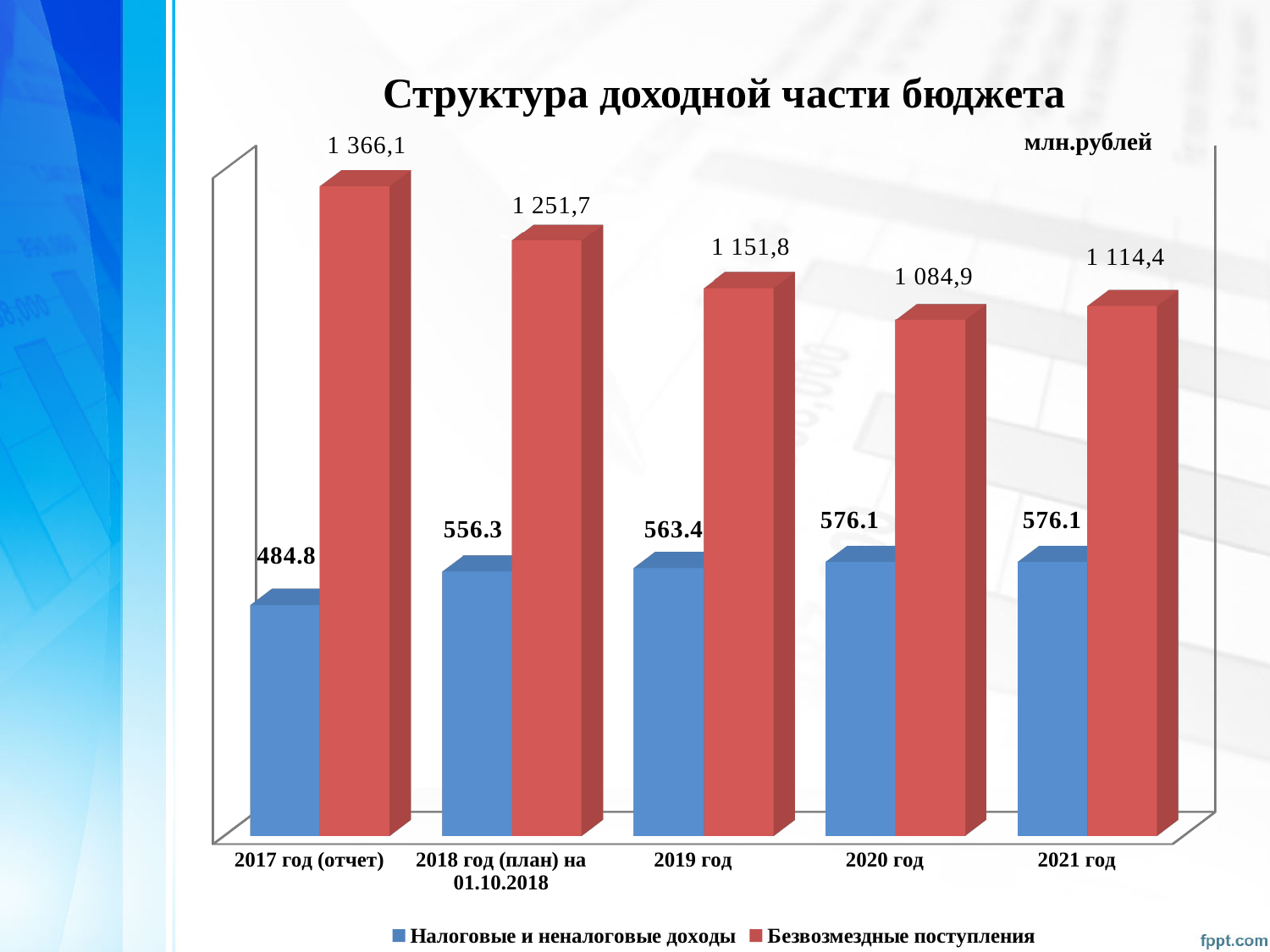
What is the value of Безвозмездные поступления for 2019 год? 1 151,8 What is the difference in Налоговые и неналоговые доходы between 2019 год and 2018 год (план) на 01.10.2018? 7.1 In which year is Безвозмездные поступления the highest? 2017 год (отчет) By how much does Безвозмездные поступления in 2017 год (отчет) exceed that in 2018 год (план) на 01.10.2018? 114,4 Which year has the larger value of Безвозмездные поступления, 2020 год or 2021 год? 2021 год In which year is Безвозмездные поступления the lowest? 2020 год How many series does the legend list? 2 What is the value of Налоговые и неналоговые доходы for 2017 год (отчет)? 484.8 What is the value of Налоговые и неналоговые доходы for 2020 год? 576.1 In which year is Налоговые и неналоговые доходы the lowest? 2017 год (отчет) What kind of chart is shown on the slide? Bar chart How many year categories are shown on the x axis? 5